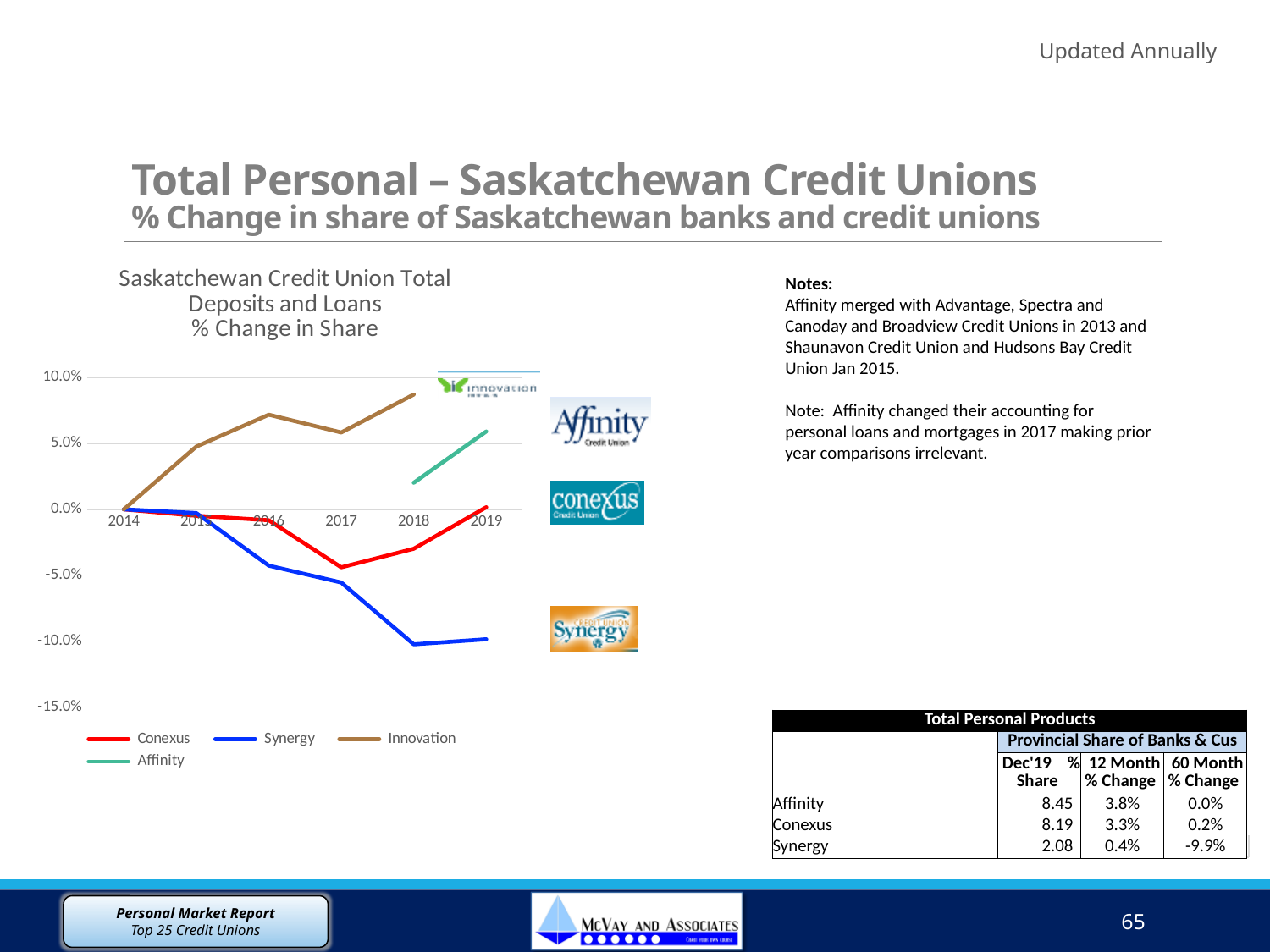
Which series has the highest value in 2016? Innovation In 2018, which is larger: the value for Innovation or the value for Synergy? Innovation Which series are listed in the chart legend? Conexus, Synergy, Innovation, Affinity How many series does the chart legend list? 4 Is the value for Innovation in 2018 greater or less than 5.0%? greater Is the value for Conexus in 2017 greater or less than 0.0%? less What kind of chart is shown on the slide? line chart Which series has the lowest value in 2018? Synergy Is the value for Synergy in 2017 greater or less than -5.0%? less Does the Synergy line rise or fall from 2014 to 2018? fall How many years are shown on the x axis of the chart? 6